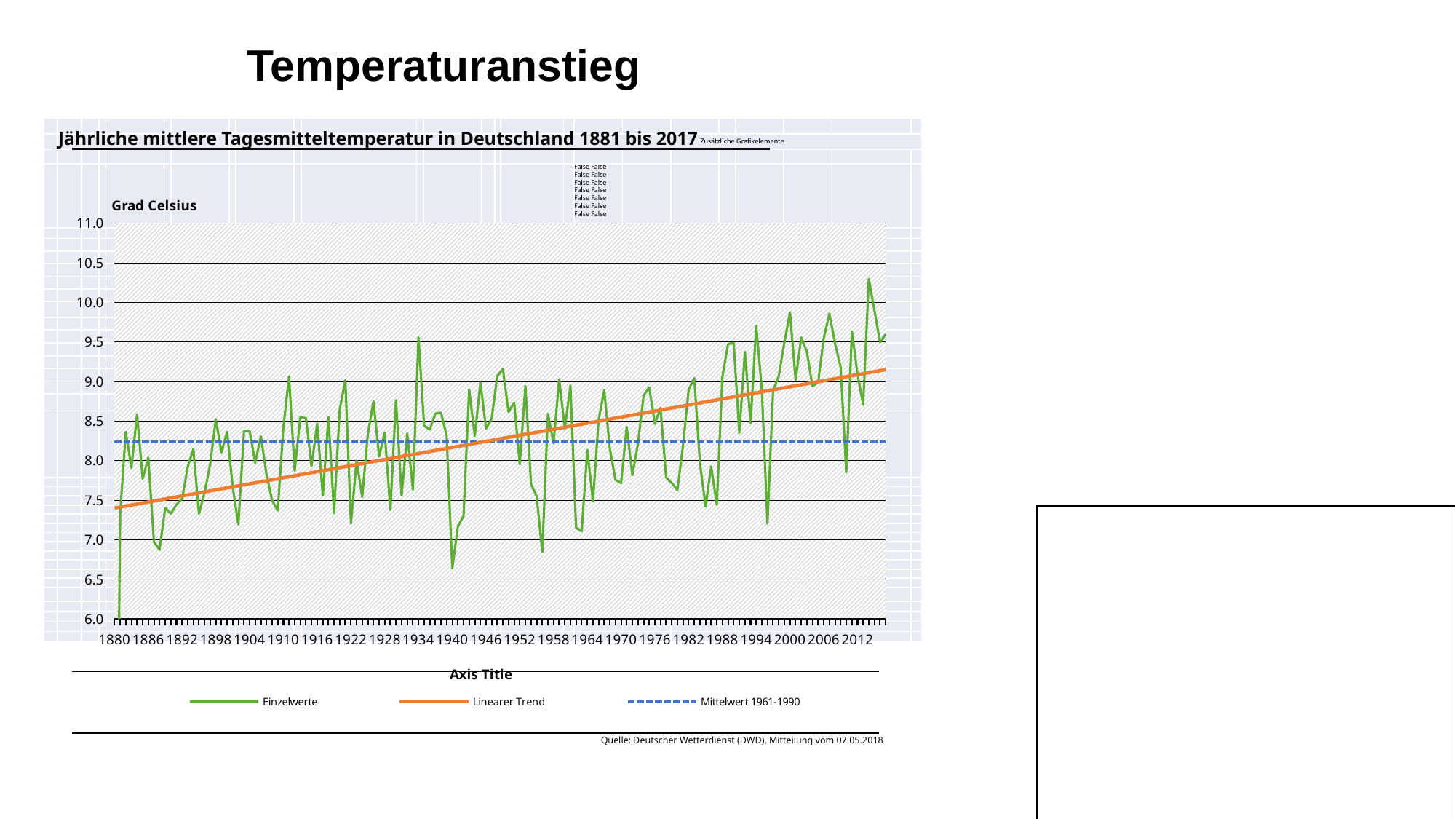
Is the value of the Mittelwert 1961-1990 line greater or less than 8.5? less Is the highest Einzelwerte value on the chart greater or less than 10.0? greater Is the Linearer Trend value at 2012 greater or less than 9.0? greater Which is larger at 2012: the Linearer Trend value or the Mittelwert 1961-1990 value? Linearer Trend How many year labels are printed on the horizontal axis? 23 What kind of chart is shown on the slide? line chart What unit is shown as the label of the vertical axis? Grad Celsius Does the Linearer Trend line rise or fall from 1880 to 2012? rise What is the title of the chart? Jährliche mittlere Tagesmitteltemperatur in Deutschland 1881 bis 2017 How many series does the legend list? 3